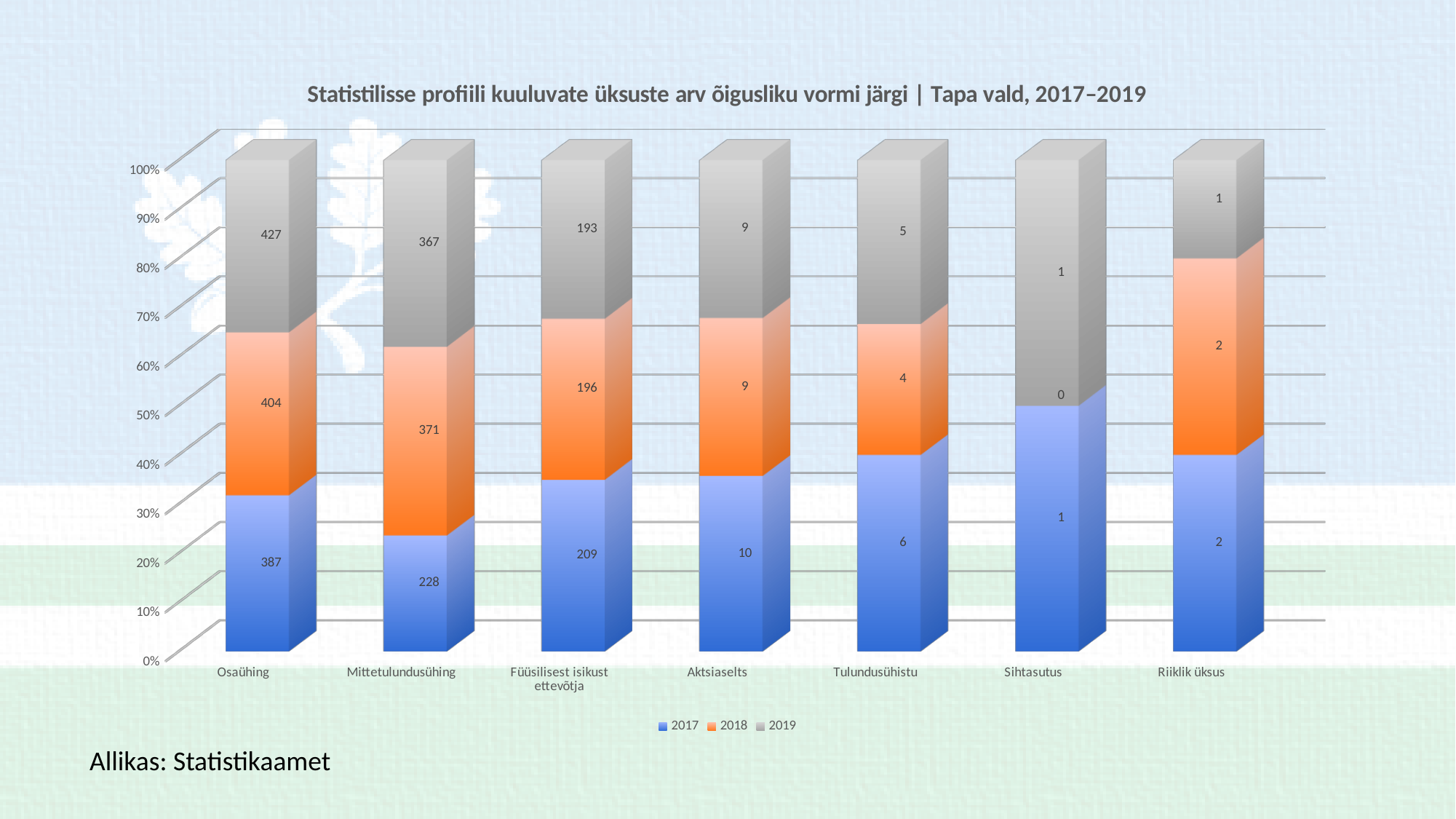
What kind of chart is this? Stacked bar chart Which category has the lowest value in 2018? Sihtasutus How many series does the legend list? 3 Which category has the highest value in 2017? Osaühing What is the value for Osaühing in 2019? 427 What is the value for Sihtasutus in 2018? 0 What is the value for Füüsilisest isikust ettevõtja in 2018? 196 What is the total of the three values for Füüsilisest isikust ettevõtja? 598 Which is larger for Mittetulundusühing: the 2018 value or the 2019 value? 2018 How many categories are shown on the x axis? 7 What is the value for Mittetulundusühing in 2017? 228 What is the difference between the 2019 and 2017 values for Osaühing? 40